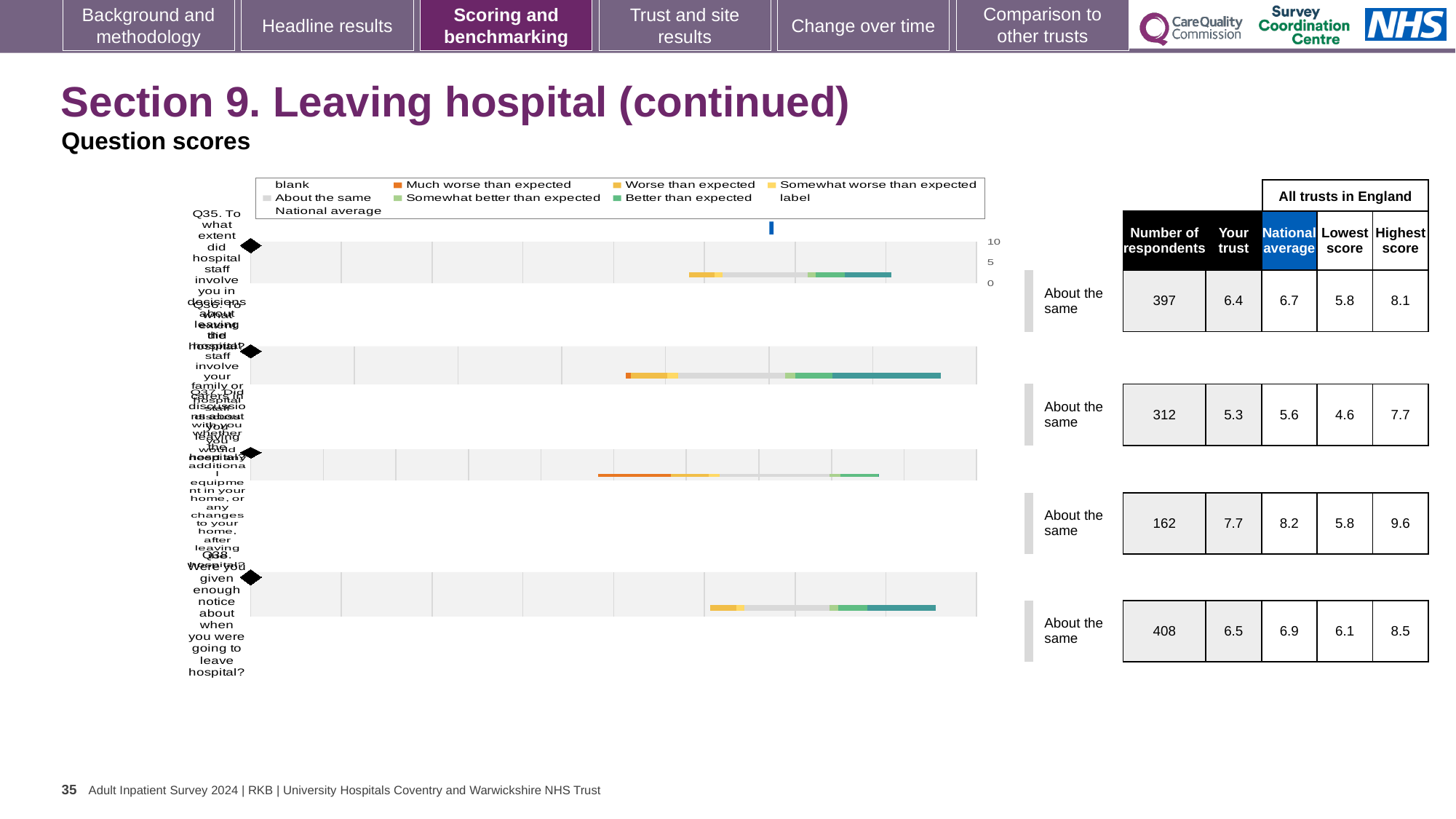
What is the national average score for Q37 (the third row) in the table? 8.2 What is the lowest score across all trusts in England for Q36 (the second row)? 4.6 In the table next to the chart, how many respondents are listed for Q35 (the first row)? 397 Which question row has the lowest number of respondents in the table? Q37 What benchmark category label is shown beside the bar for Q37 (the third row)? About the same Which has the larger 'Your trust' score: Q35 (first row) or Q38 (fourth row)? Q38 What is the 'Your trust' score for Q36 (the second row) in the table? 5.3 For Q35 (the first row), what is the difference between the national average and the 'Your trust' score? 0.3 Which question row has the highest 'Your trust' score in the table? Q37 What is the highest score across all trusts in England for Q38 (the fourth row)? 8.5 What kind of chart is shown on the slide? bar chart How many question bars are plotted in the chart? 4